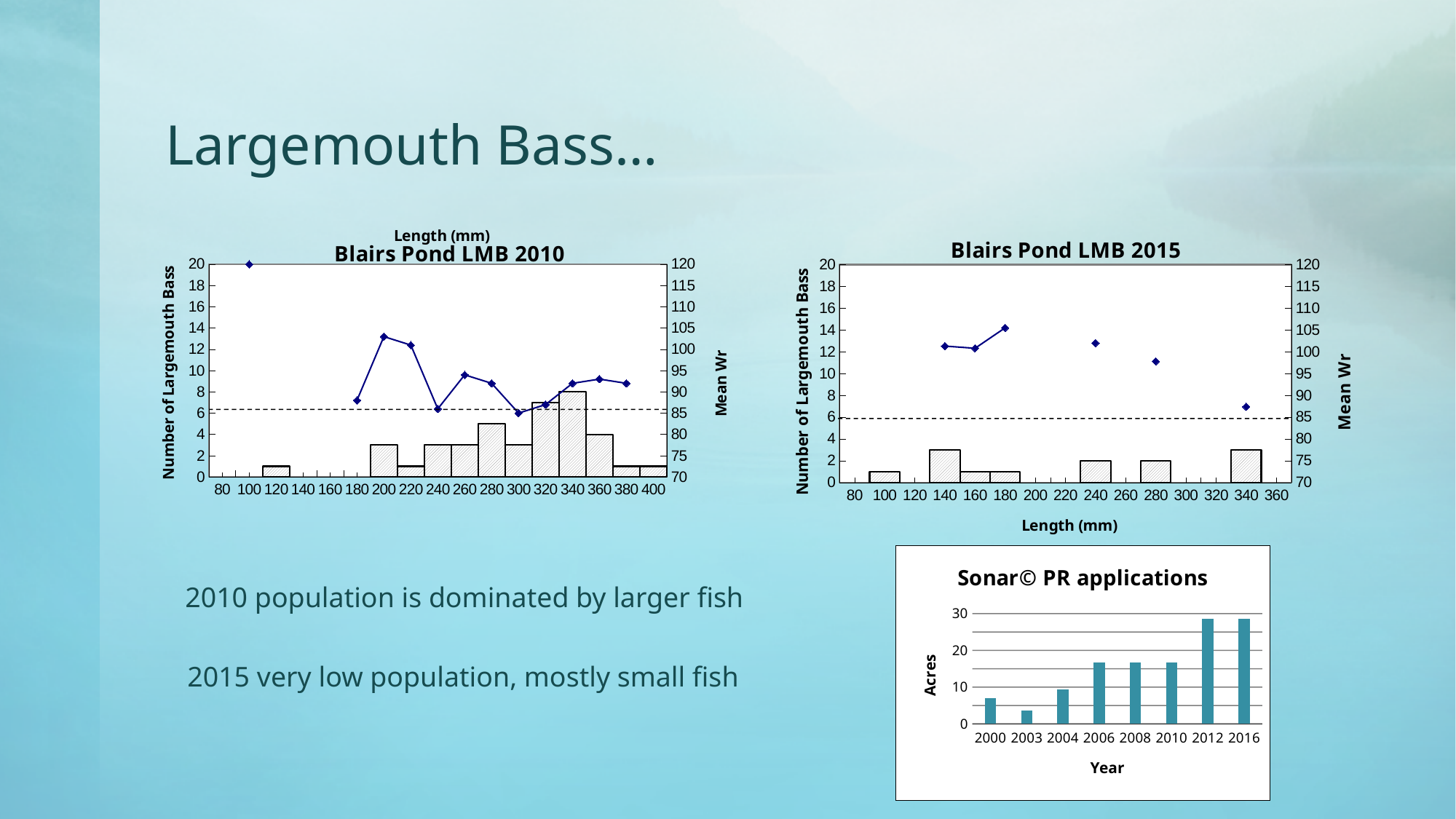
In the "Sonar© PR applications" chart, which year has the lowest number of acres? 2003 In the "Blairs Pond LMB 2015" chart, at which length (mm) is the lowest Mean Wr point? 340 In the "Sonar© PR applications" chart, which is larger, the value for 2000 or the value for 2004? 2004 In the "Blairs Pond LMB 2010" chart, at which length (mm) is the tallest bar? 340 In the "Sonar© PR applications" chart, is the value for 2003 greater or less than 10? less What is the label of the right-hand vertical axis on the "Blairs Pond LMB 2010" chart? Mean Wr What kind of chart is the "Sonar© PR applications" chart? bar chart In the "Blairs Pond LMB 2015" chart, how many largemouth bass are in the 240 mm bar? 2 How many years are shown on the x axis of the "Sonar© PR applications" chart? 8 In the "Blairs Pond LMB 2010" chart, how many largemouth bass are in the 340 mm bar? 8 In the "Sonar© PR applications" chart, is the value for 2012 greater or less than 20? greater In the "Blairs Pond LMB 2010" chart, is the Mean Wr value at 100 mm greater or less than 115? greater